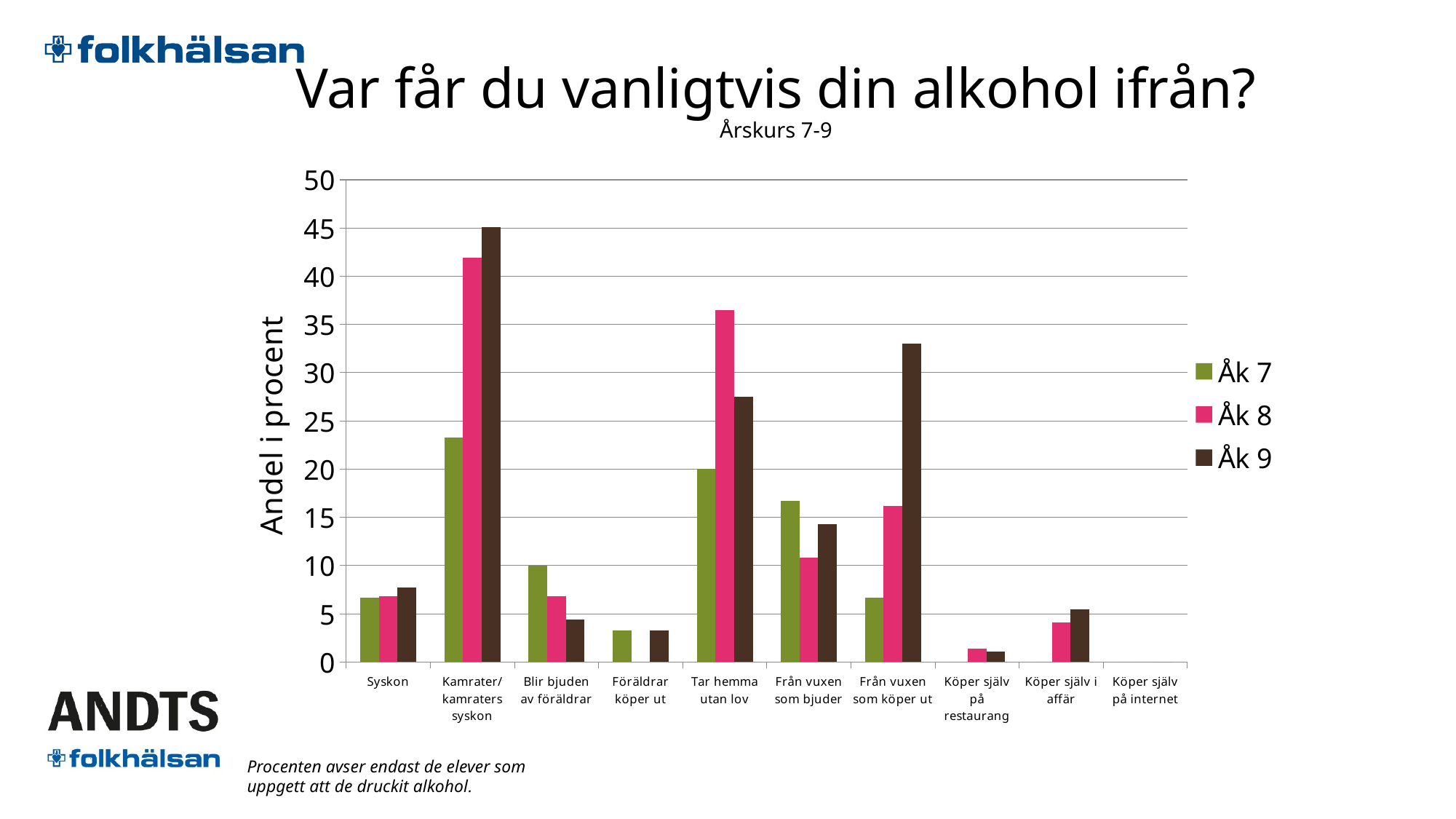
Is the Åk 9 value for Kamrater/kamraters syskon greater or less than 40? greater Is the Åk 8 value for Tar hemma utan lov greater or less than 30? greater For Tar hemma utan lov, which series has the larger value, Åk 8 or Åk 9? Åk 8 How many series does the legend list? 3 What is the title of the y axis? Andel i procent For Från vuxen som köper ut, which series has the larger value, Åk 8 or Åk 9? Åk 9 Is the Åk 9 value for Från vuxen som köper ut greater or less than 30? greater For the Åk 8 series, which category has the highest value? Kamrater/kamraters syskon How many categories are shown along the x axis? 10 What kind of chart is shown on the slide? bar chart For the Åk 7 series, which category has the highest value? Kamrater/kamraters syskon For the Åk 9 series, which category has the highest value? Kamrater/kamraters syskon